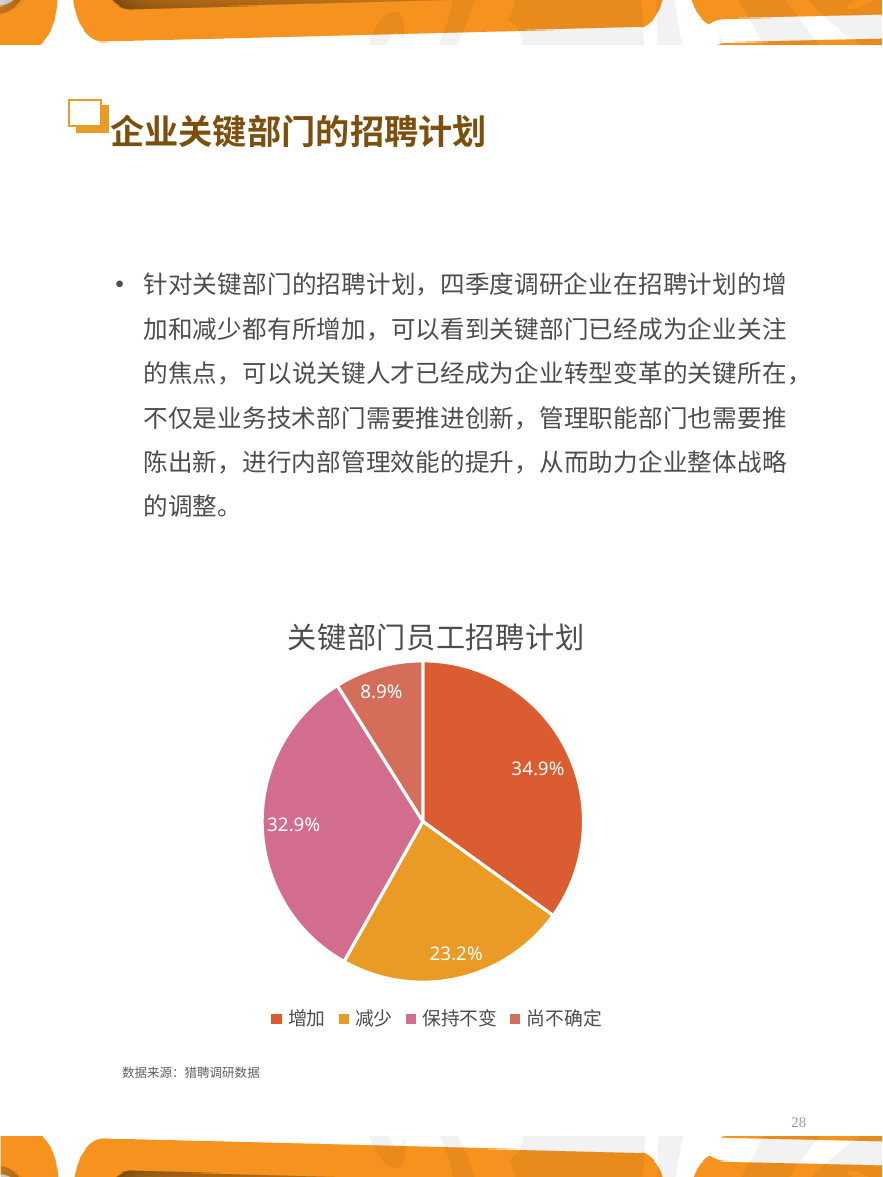
Which category has the smallest slice of the pie? 尚不确定 What share of the pie does 尚不确定 represent? 8.9% What type of chart is shown on the slide? pie chart What is the difference in percentage points between 增加 and 减少? 11.7 Which category has the largest slice of the pie? 增加 What share of the pie does 增加 represent? 34.9% Which is larger, the share for 保持不变 or the share for 减少? 保持不变 What share of the pie does 减少 represent? 23.2% What share of the pie does 保持不变 represent? 32.9% What is the difference in percentage points between 保持不变 and 尚不确定? 24 How many categories does the legend list? 4 What is the title of the chart? 关键部门员工招聘计划